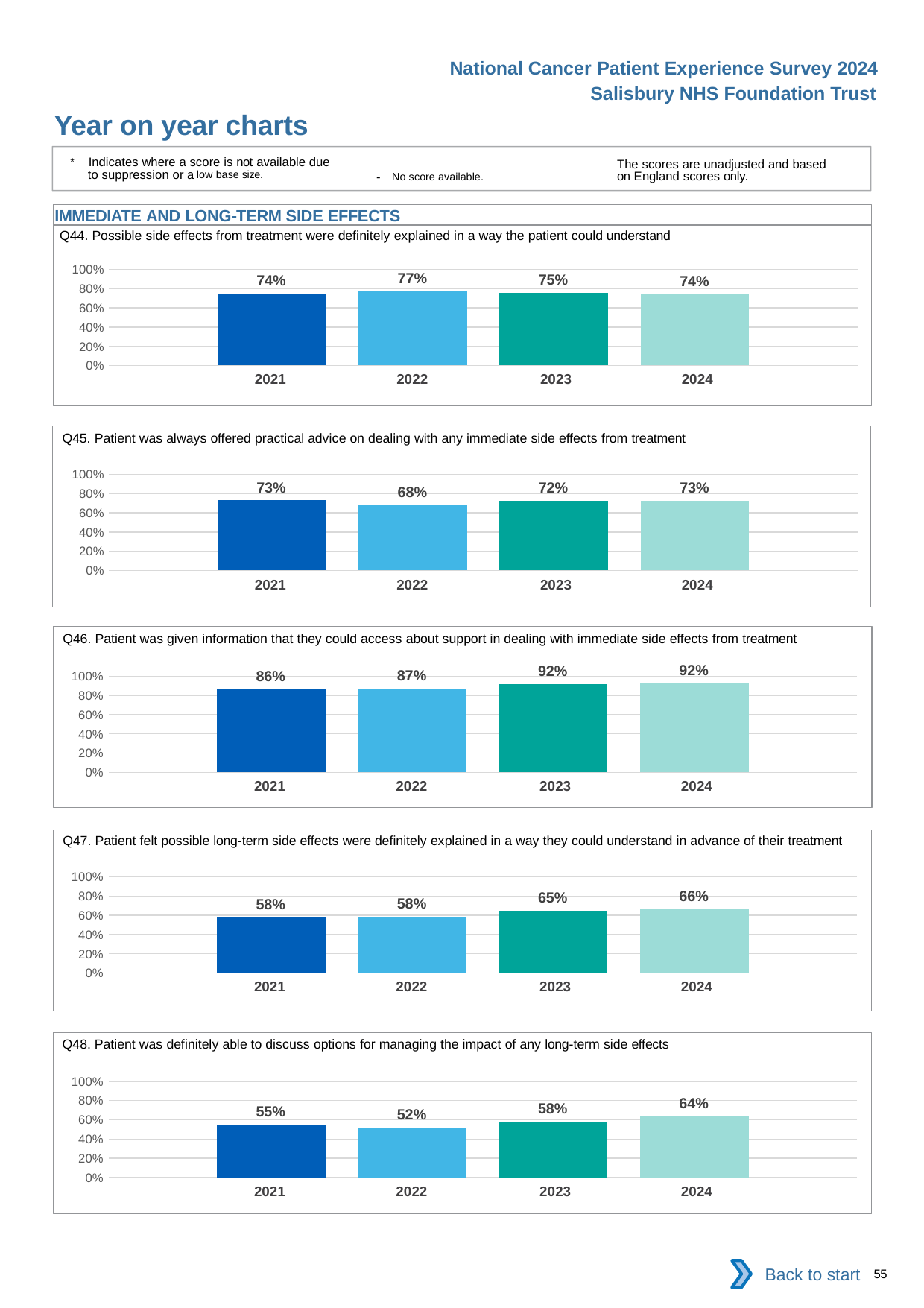
In the Q48 chart, which year has the highest value? 2024 In the Q45 chart, which year has the lowest value? 2022 In the Q46 chart, what is the value for 2023? 92% In the Q48 chart, do the values rise or fall from 2022 to 2024? rise In the Q44 chart, what is the value for 2022? 77% What kind of chart is the Q44 chart? bar chart In the Q44 chart, which year has the highest value? 2022 In the Q47 chart, what is the value for 2024? 66% In the Q45 chart, what is the difference between the 2021 and 2022 values? 5% In the Q46 chart, is the value for 2021 larger or smaller than the value for 2022? smaller How many years are shown on the x axis of the Q48 chart? 4 In the Q47 chart, what is the difference between the 2024 and 2021 values? 8%